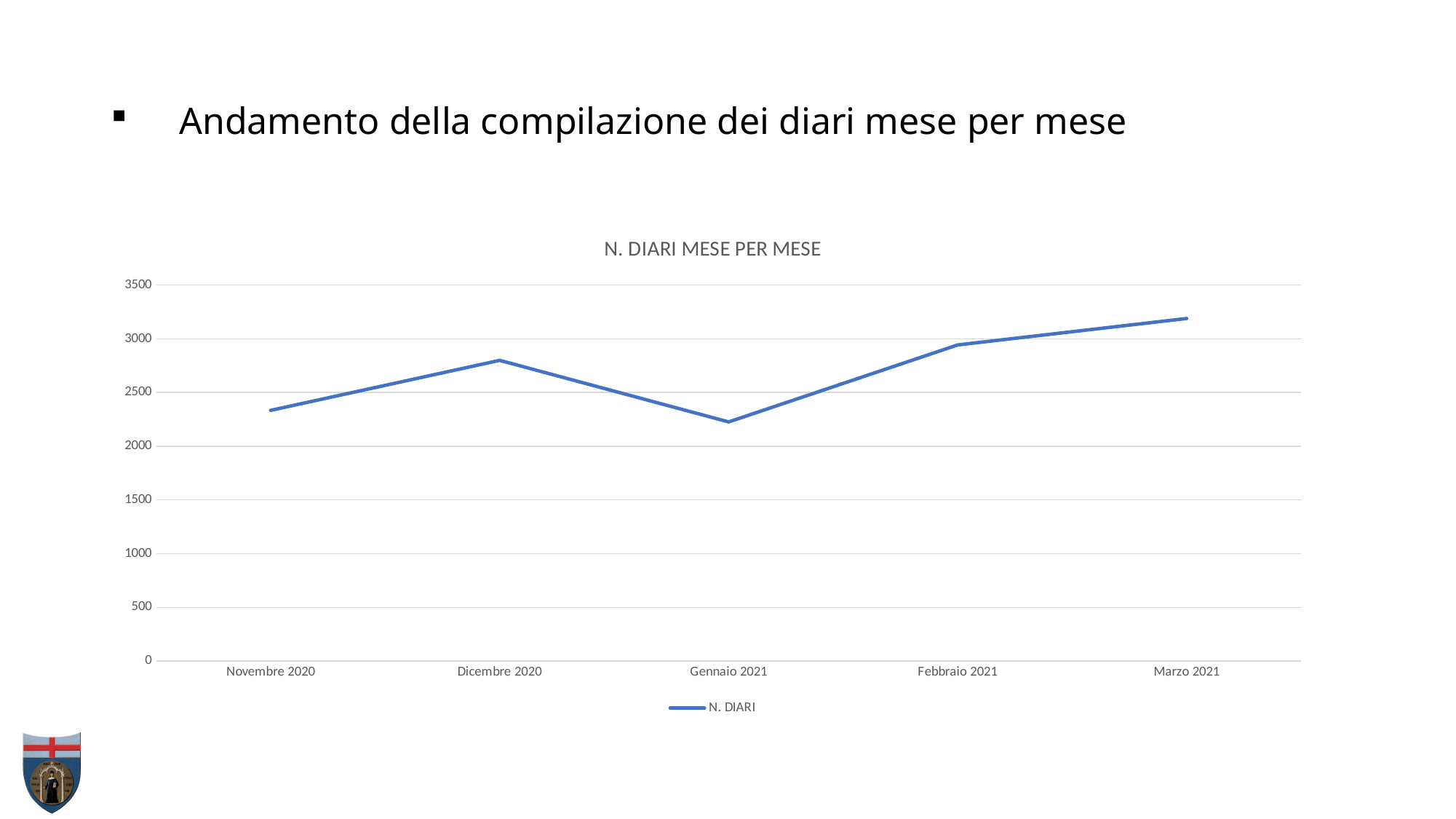
Is the value for Marzo 2021 greater or less than 3000? greater Which month has the highest number of diari? Marzo 2021 How many months are plotted on the x axis? 5 Which month has the lowest number of diari? Gennaio 2021 What kind of chart is shown on the slide? line chart Do the values rise or fall from Gennaio 2021 to Marzo 2021? rise Is the value for Gennaio 2021 greater or less than 2000? greater Is the value for Dicembre 2020 greater or less than 2500? greater Which is larger, the value for Dicembre 2020 or the value for Febbraio 2021? Febbraio 2021 What is the title of the chart? N. DIARI MESE PER MESE How many series does the legend list? 1